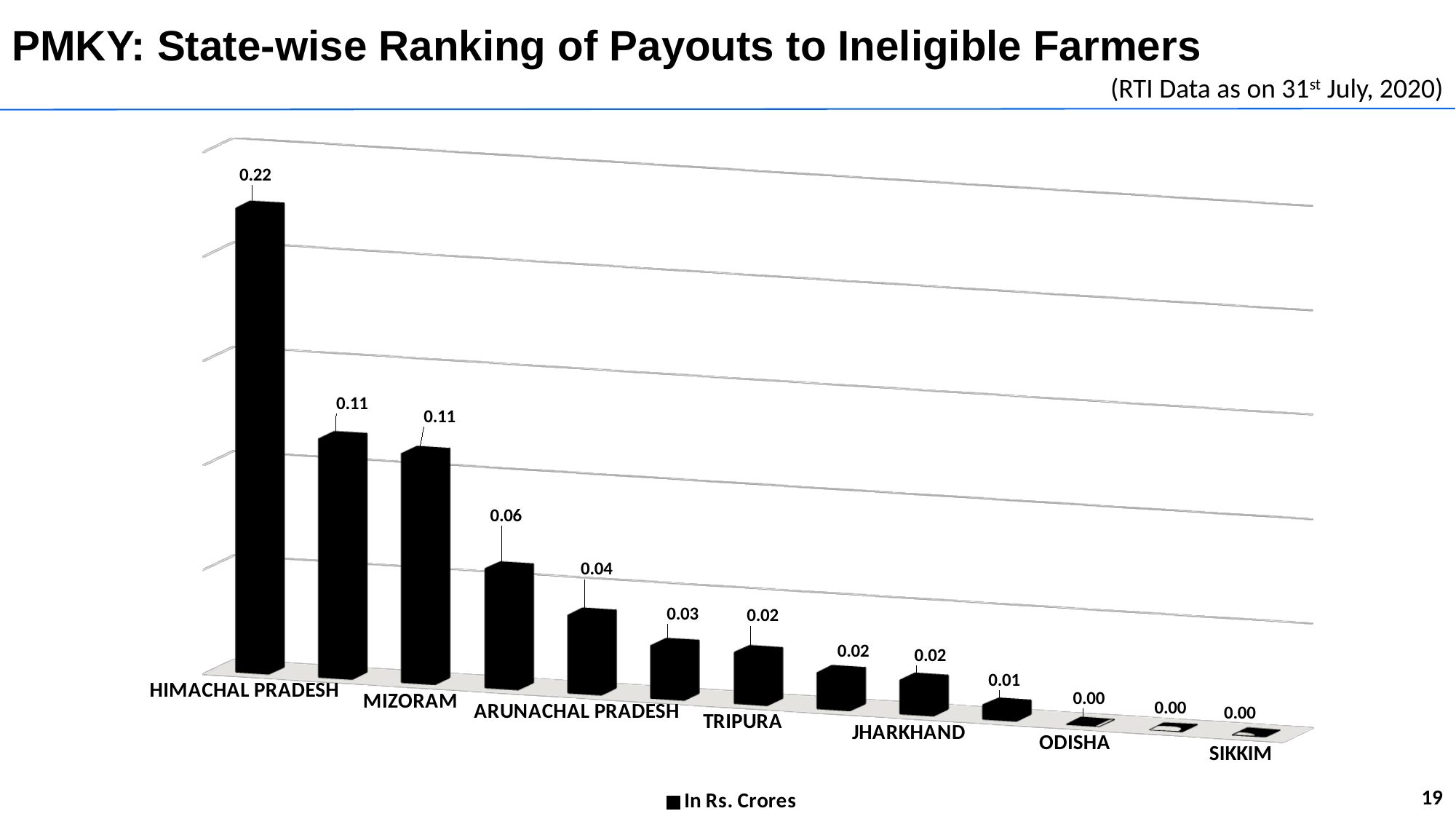
What is the value for Arunachal Pradesh? 0.04 What is the value for Mizoram? 0.11 Do the values rise or fall from left to right along the x axis? Fall Which state has the highest payout to ineligible farmers? Himachal Pradesh What is the value for Odisha? 0.00 What kind of chart is shown on the slide? Bar chart What is the value for Tripura? 0.02 How many bars are plotted in the chart? 13 How many series does the legend list? 1 Which is larger, the value for Mizoram or the value for Arunachal Pradesh? Mizoram What is the difference between the values for Himachal Pradesh and Mizoram? 0.11 What is the value for Himachal Pradesh? 0.22